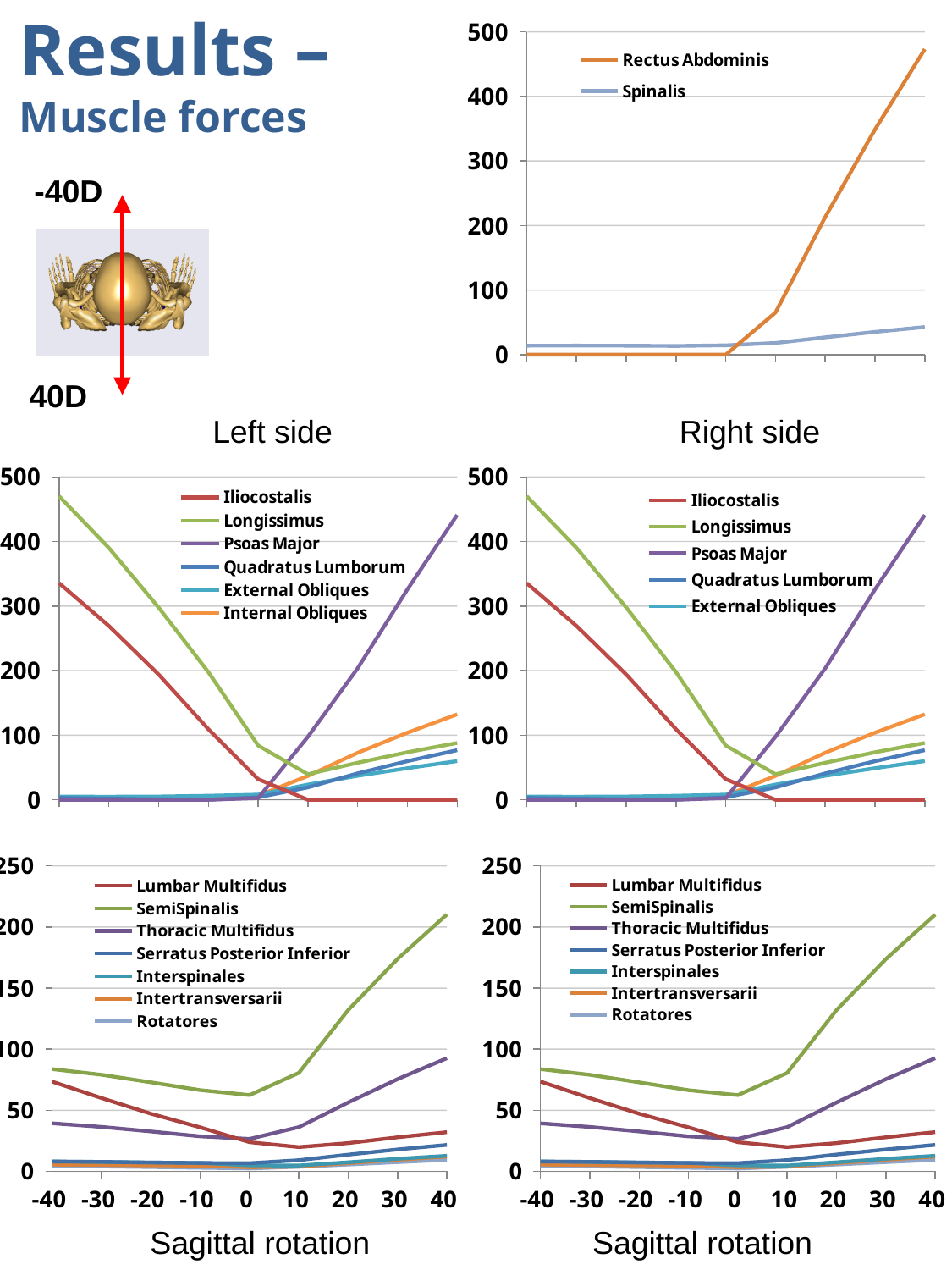
How many series does the legend of the upper 'Left side' chart list? 6 In the upper 'Left side' chart, which series has the highest value at sagittal rotation -40? Longissimus How many series does the legend of the lower-left chart (Lumbar Multifidus, SemiSpinalis, ...) list? 7 What kind of chart is the top-right chart with Rectus Abdominis and Spinalis? line chart In the top-right chart, does the Rectus Abdominis line rise or fall across the right half of the x axis? rises In the upper 'Left side' chart, is the value for Longissimus at -40 greater or less than 400? greater How many series does the legend of the upper 'Right side' chart list? 5 In the upper 'Left side' chart, which series has the highest value at sagittal rotation 40? Psoas Major In the top-right chart, is the value for Rectus Abdominis at the rightmost point greater or less than 400? greater In the lower-left chart, is the value for SemiSpinalis at sagittal rotation 40 greater or less than 200? greater What is the x-axis title of the lower-right chart? Sagittal rotation